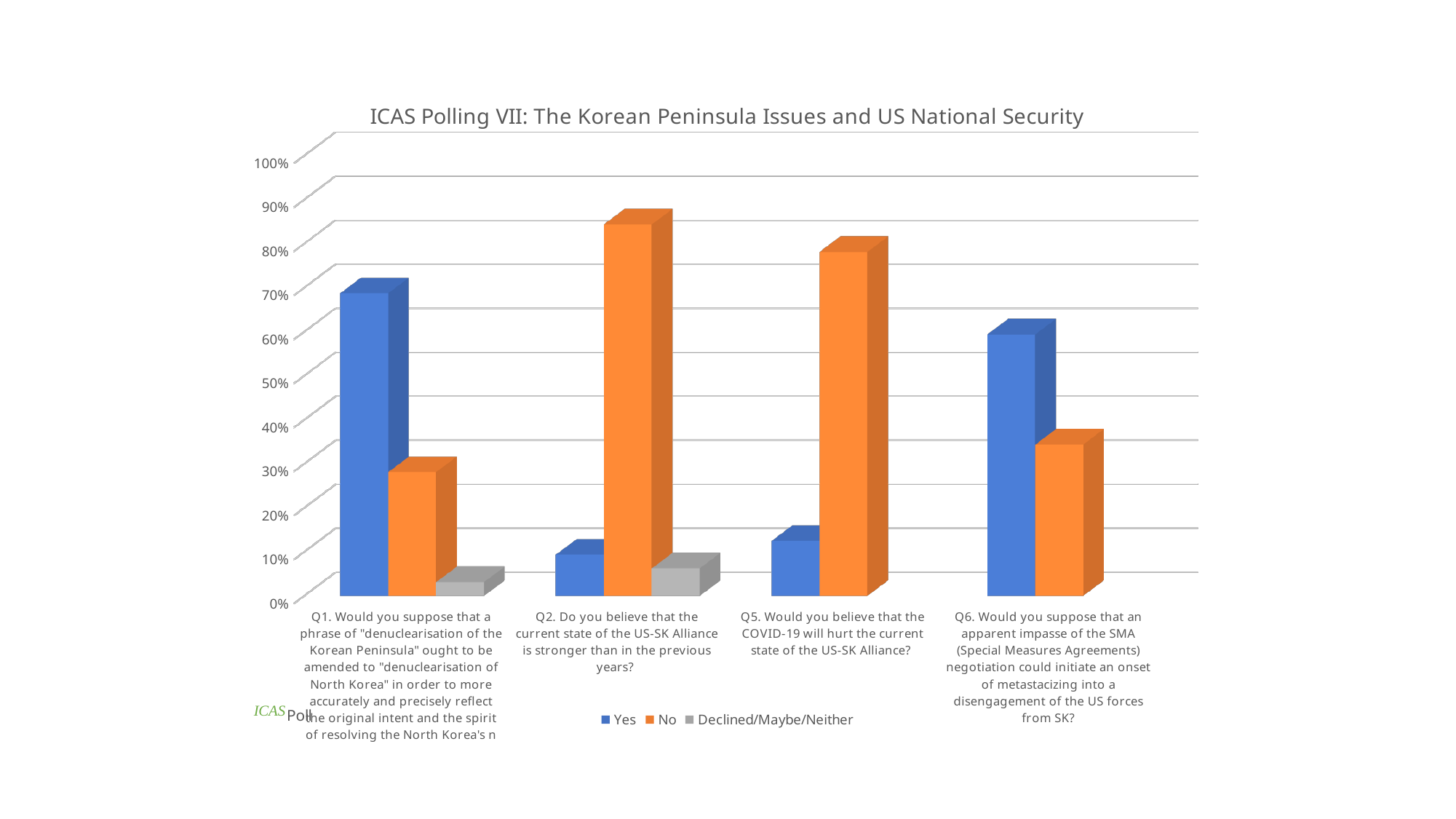
Which question has the highest Yes value? Q1 How many series does the legend list? 3 Is the No value for Q5 greater or less than 70%? greater Is the No value for Q6 greater or less than 50%? less Which question has the highest No value? Q2 Which series is shown in orange in the legend? No For Q1, which is larger, the Yes bar or the No bar? Yes What type of chart is shown on the slide? bar chart What is the title of the chart? ICAS Polling VII: The Korean Peninsula Issues and US National Security For Q2, which is larger, the Yes bar or the No bar? No How many poll questions (categories) are plotted on the x axis? 4 Is the Yes value for Q1 greater or less than 60%? greater